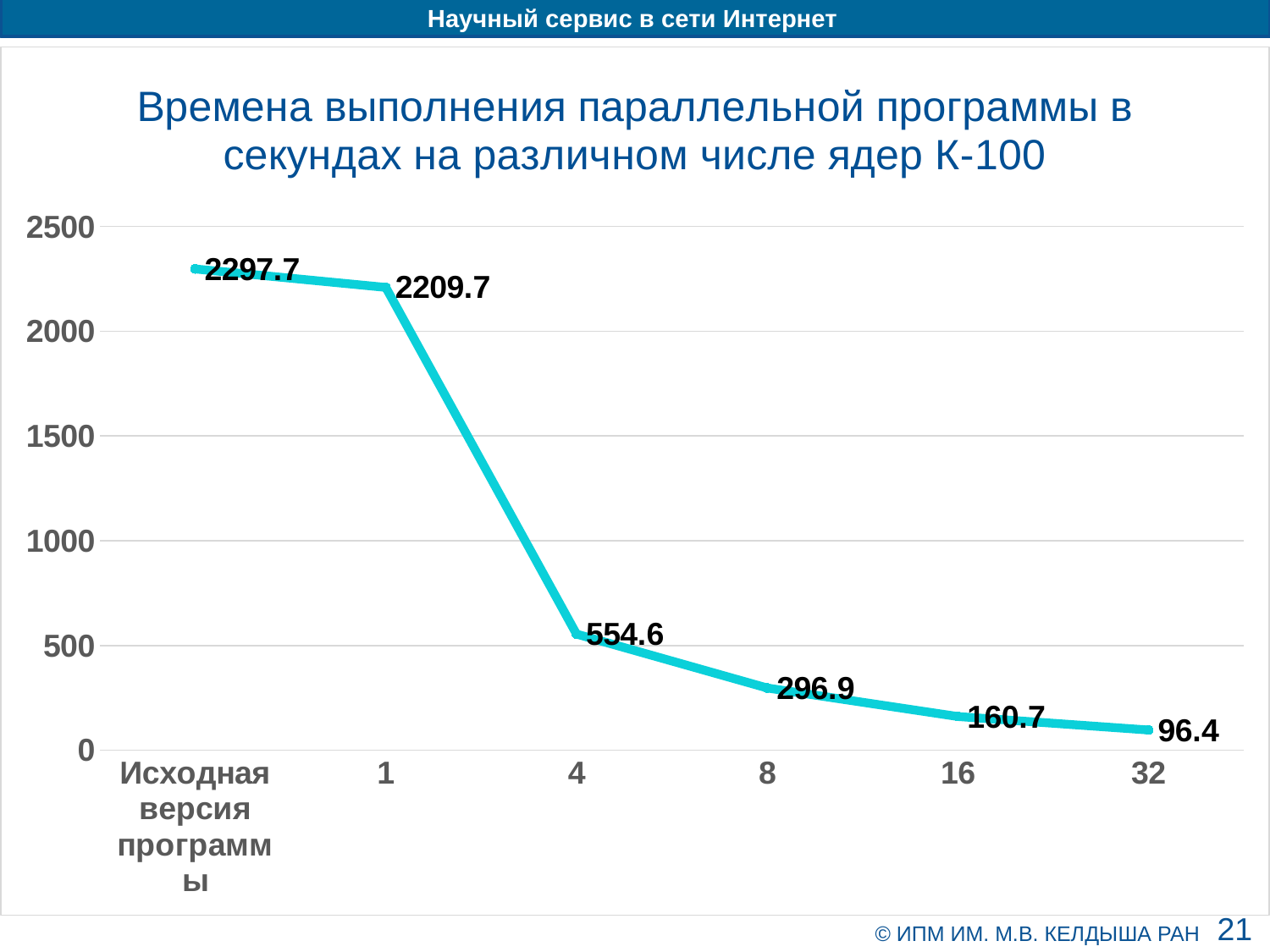
What is the difference between the execution time on 1 core and on 4 cores? 1655.1 How many data points are plotted on the chart? 6 Do the execution times rise or fall as the number of cores increases along the x axis? Fall What is the execution time on 32 cores? 96.4 What is the difference between the execution time on 8 cores and on 16 cores? 136.2 Which is larger: the execution time on 8 cores or on 16 cores? 8 cores Which category has the highest execution time? Исходная версия программы Which number of cores has the lowest execution time? 32 What is the execution time on 1 core? 2209.7 What kind of chart is shown on the slide? Line chart What is the execution time on 4 cores? 554.6 What is the execution time for the original version of the program (Исходная версия программы)? 2297.7